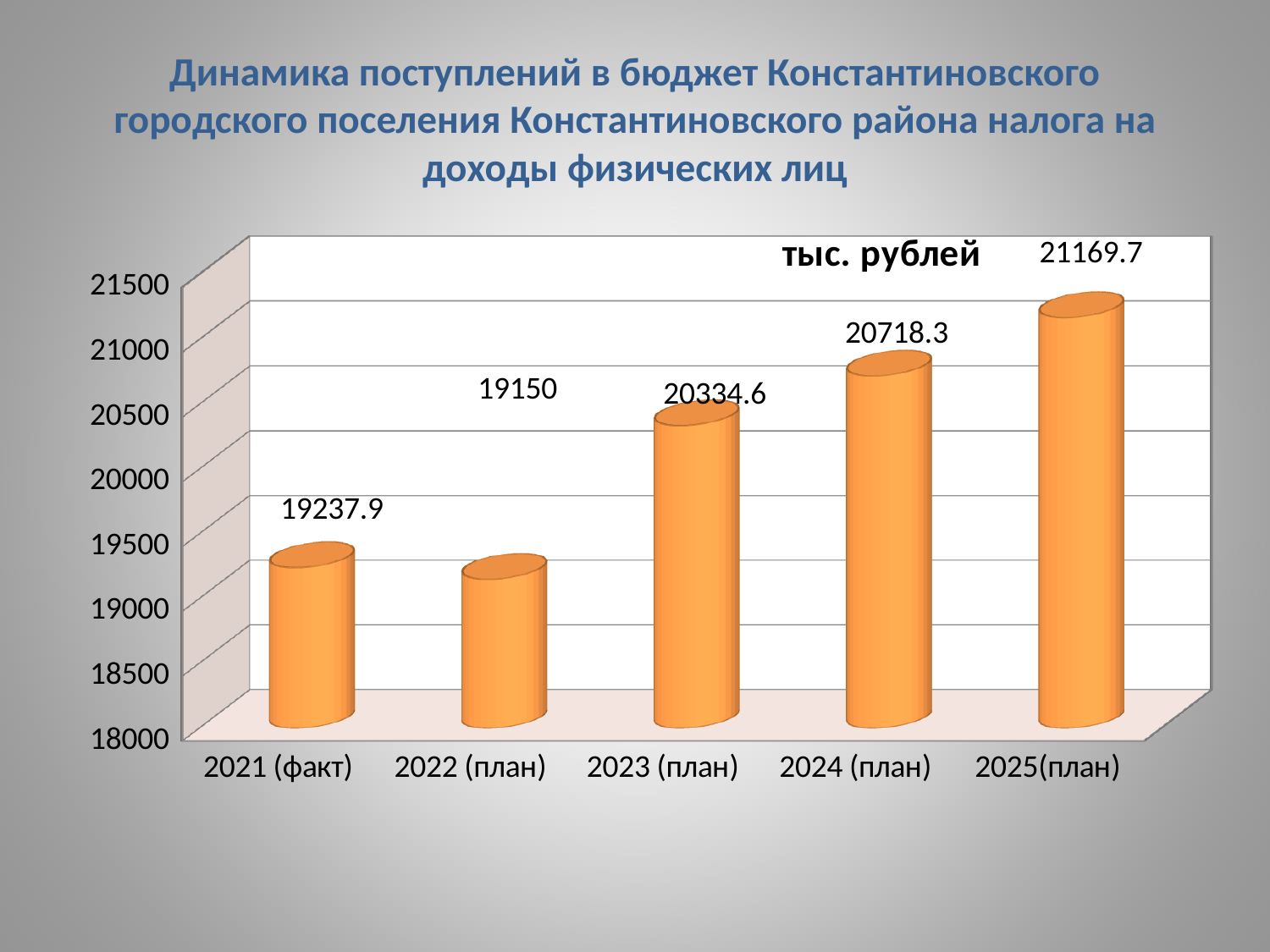
What is the value for 2023 (план)? 20334.6 Which is larger, the value for 2021 (факт) or the value for 2022 (план)? 2021 (факт) What kind of chart is shown on the slide? bar chart How many categories are shown on the x axis? 5 Which category has the highest value? 2025(план) What is the difference between the values for 2025(план) and 2021 (факт)? 1931.8 Is the value for 2024 (план) greater or less than 20500? greater Which category has the lowest value? 2022 (план) What is the value for 2025(план)? 21169.7 What is the difference between the values for 2024 (план) and 2023 (план)? 383.7 What is the value for 2021 (факт)? 19237.9 What unit of measurement is indicated on the chart? тыс. рублей